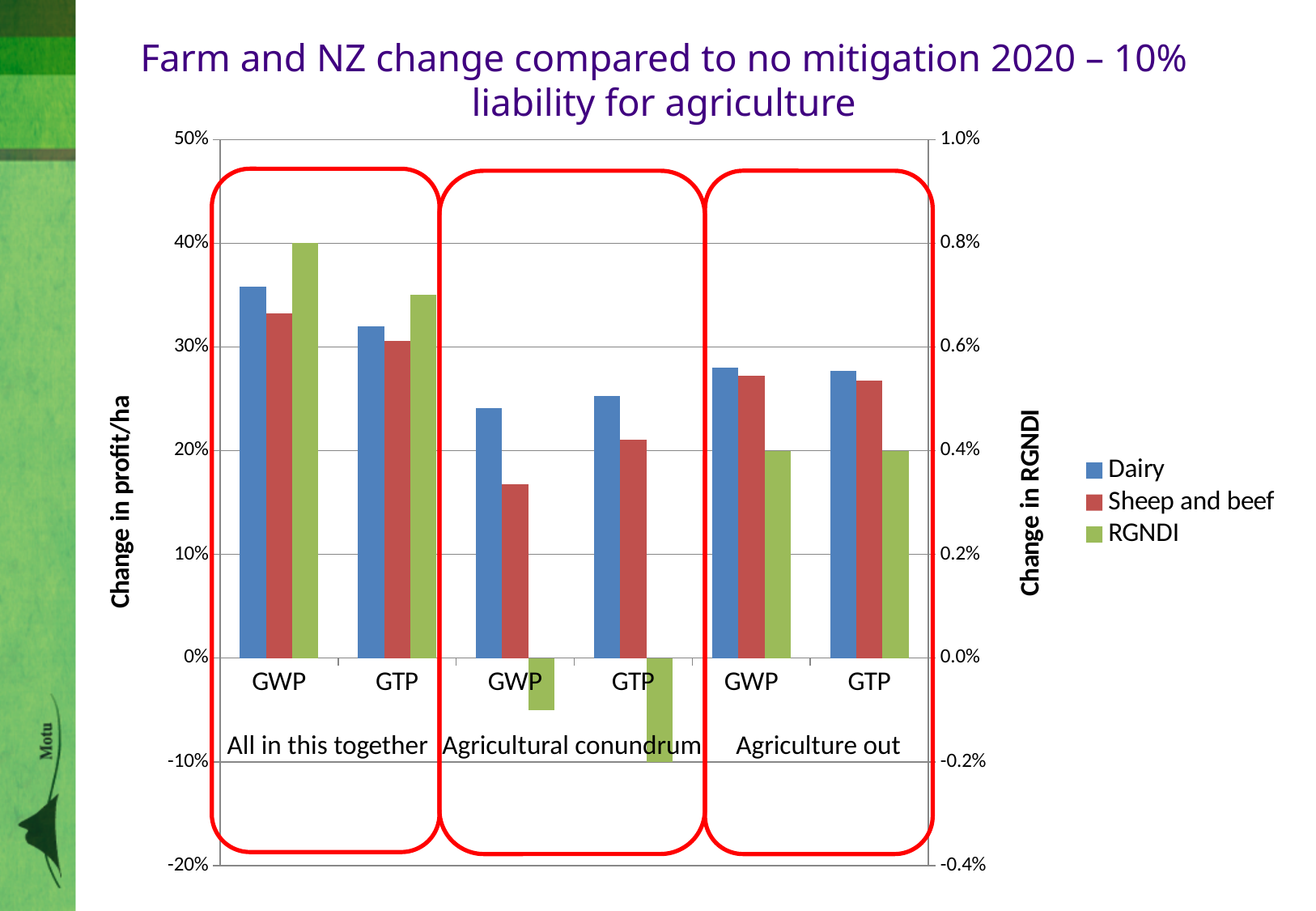
Is the Dairy value for GWP under 'All in this together' greater or less than 30%? greater Which series are listed in the legend? Dairy, Sheep and beef, RGNDI Is the Sheep and beef value for GWP under 'Agricultural conundrum' greater or less than 20%? less How many series does the legend list? 3 How many GWP/GTP category groups are plotted along the x axis? 6 Is the Dairy value for GTP under 'Agricultural conundrum' greater or less than 20%? greater Under 'Agricultural conundrum' GWP, which is larger: Dairy or Sheep and beef? Dairy What kind of chart is shown on the slide? bar chart In which scenario and metric is the Sheep and beef bar lowest? Agricultural conundrum, GWP In which scenario and metric is the Dairy bar highest? All in this together, GWP What is the label of the right-hand vertical axis? Change in RGNDI